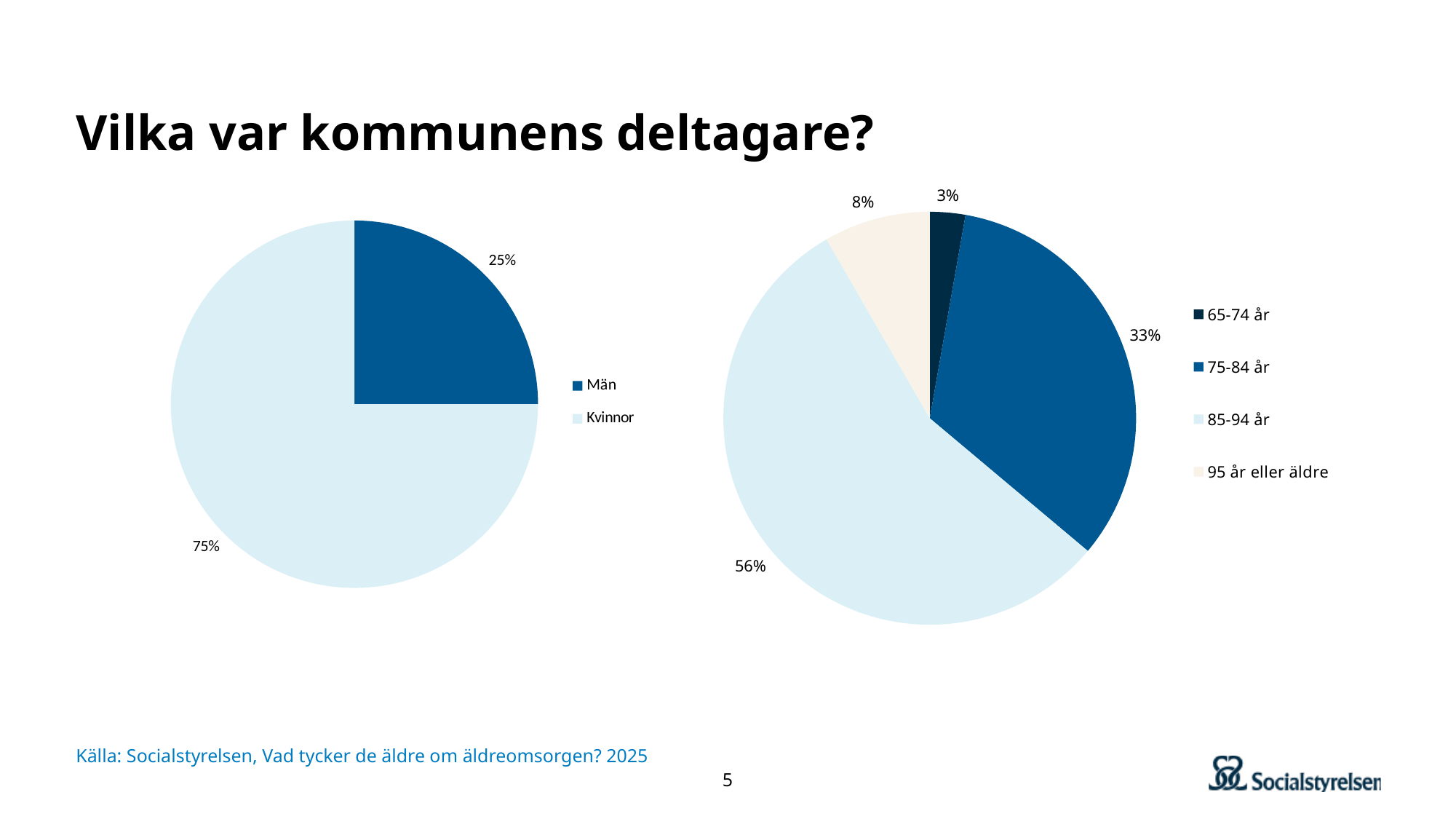
In the right pie chart, which age group has the smallest share? 65-74 år In the right pie chart, what share of participants are 95 år eller äldre? 8% In the right pie chart, what is the difference in percentage points between 85-94 år and 75-84 år? 23 In the left pie chart, what is the difference in percentage points between Kvinnor and Män? 50 In the right pie chart, what share of participants are 85-94 år? 56% How many categories does the legend of the left pie chart list? 2 In the right pie chart, what share of participants are 75-84 år? 33% In the left pie chart, which category has the larger share, Män or Kvinnor? Kvinnor What type of chart is used on the right side of the slide? Pie chart In the right pie chart, which age group has the largest share? 85-94 år In the left pie chart, what share of participants are Män? 25% In the left pie chart, what share of participants are Kvinnor? 75%